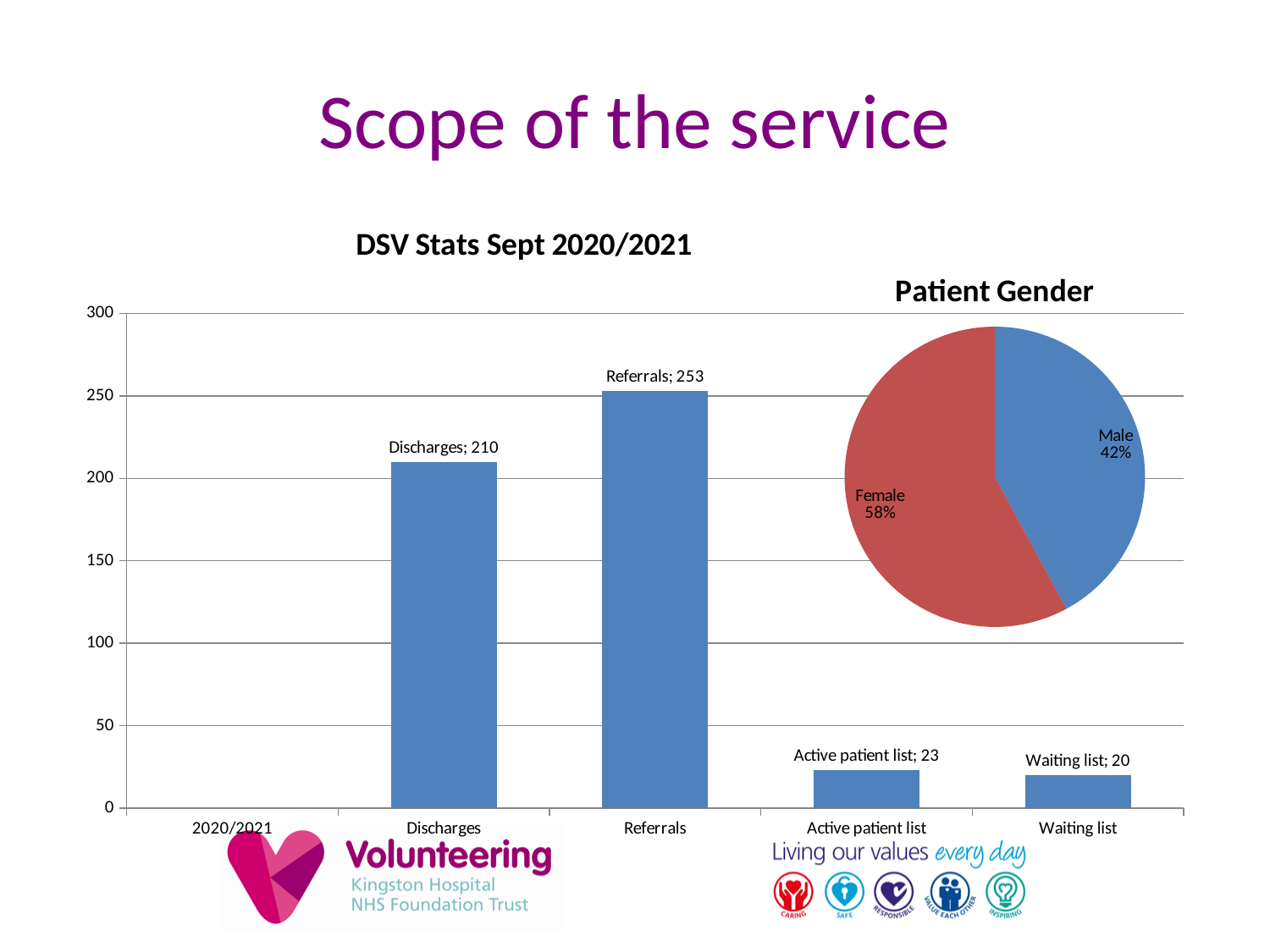
In the DSV Stats Sept 2020/2021 chart, which category has the highest value? Referrals In the DSV Stats Sept 2020/2021 chart, is the value for Discharges greater or less than 200? greater In the Patient Gender chart, which slice is larger, Male or Female? Female In the DSV Stats Sept 2020/2021 chart, which category has the lowest value? Waiting list In the DSV Stats Sept 2020/2021 chart, what is the value for Discharges? 210 What kind of chart is the DSV Stats Sept 2020/2021 chart? bar chart In the Patient Gender chart, what share of patients is Female? 58% In the DSV Stats Sept 2020/2021 chart, how many bars are plotted? 4 In the DSV Stats Sept 2020/2021 chart, what is the value for Waiting list? 20 In the DSV Stats Sept 2020/2021 chart, what is the difference between Referrals and Discharges? 43 In the DSV Stats Sept 2020/2021 chart, what is the value for Active patient list? 23 In the DSV Stats Sept 2020/2021 chart, what is the value for Referrals? 253